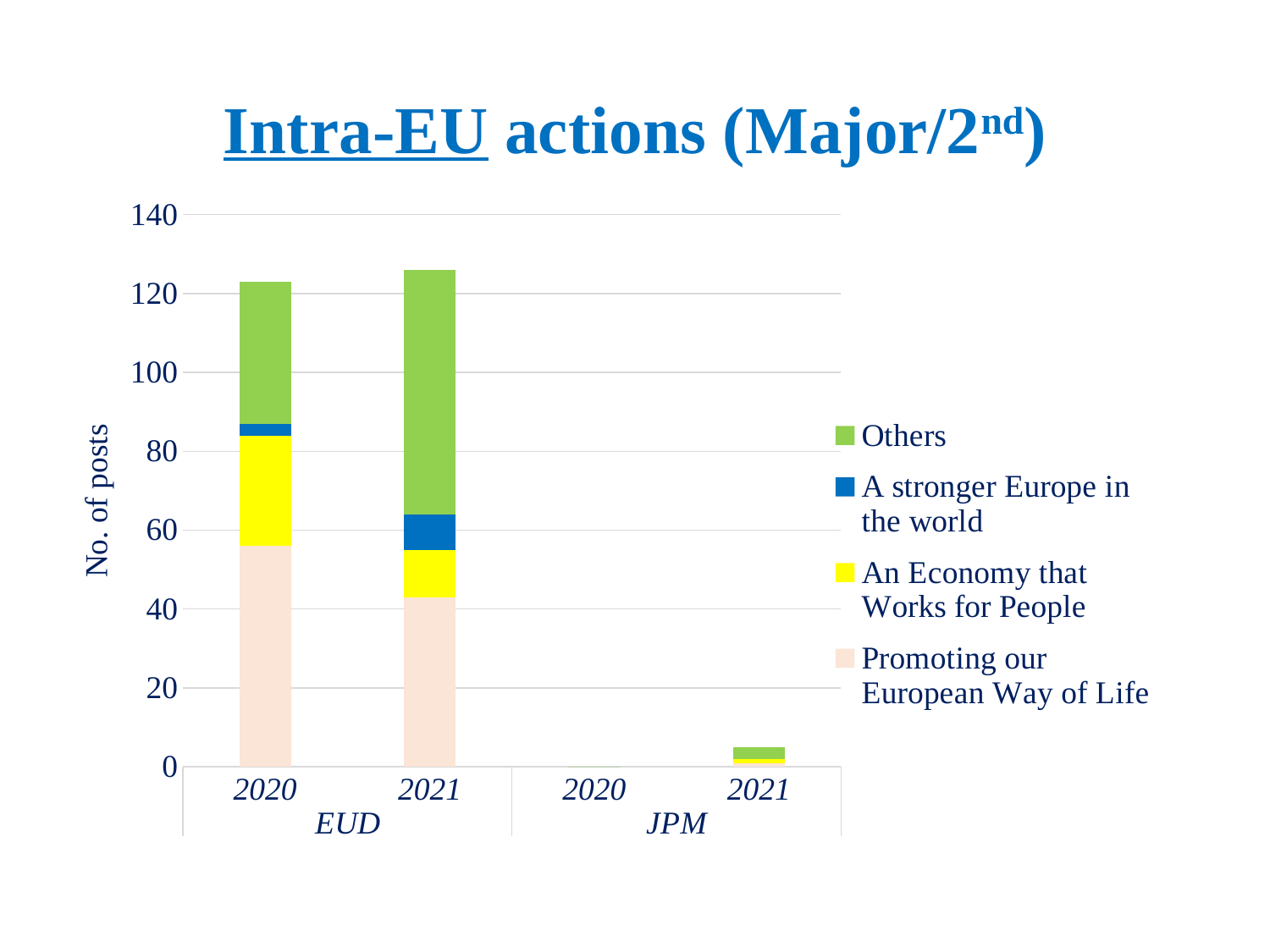
Is the total for EUD 2020 greater or less than 100? greater Which bar has the lowest total number of posts? JPM 2020 Is the 'Promoting our European Way of Life' value for EUD 2021 greater or less than 60? less Which has the larger 'Promoting our European Way of Life' segment, EUD 2020 or EUD 2021? EUD 2020 What kind of chart is shown on the slide? Stacked bar chart How many series does the legend list? 4 How many bars (year/group combinations) are plotted on the chart? 4 Is the total for JPM 2021 greater or less than 20? less What is the label on the vertical axis? No. of posts Which has the larger 'Others' segment, EUD 2020 or EUD 2021? EUD 2021